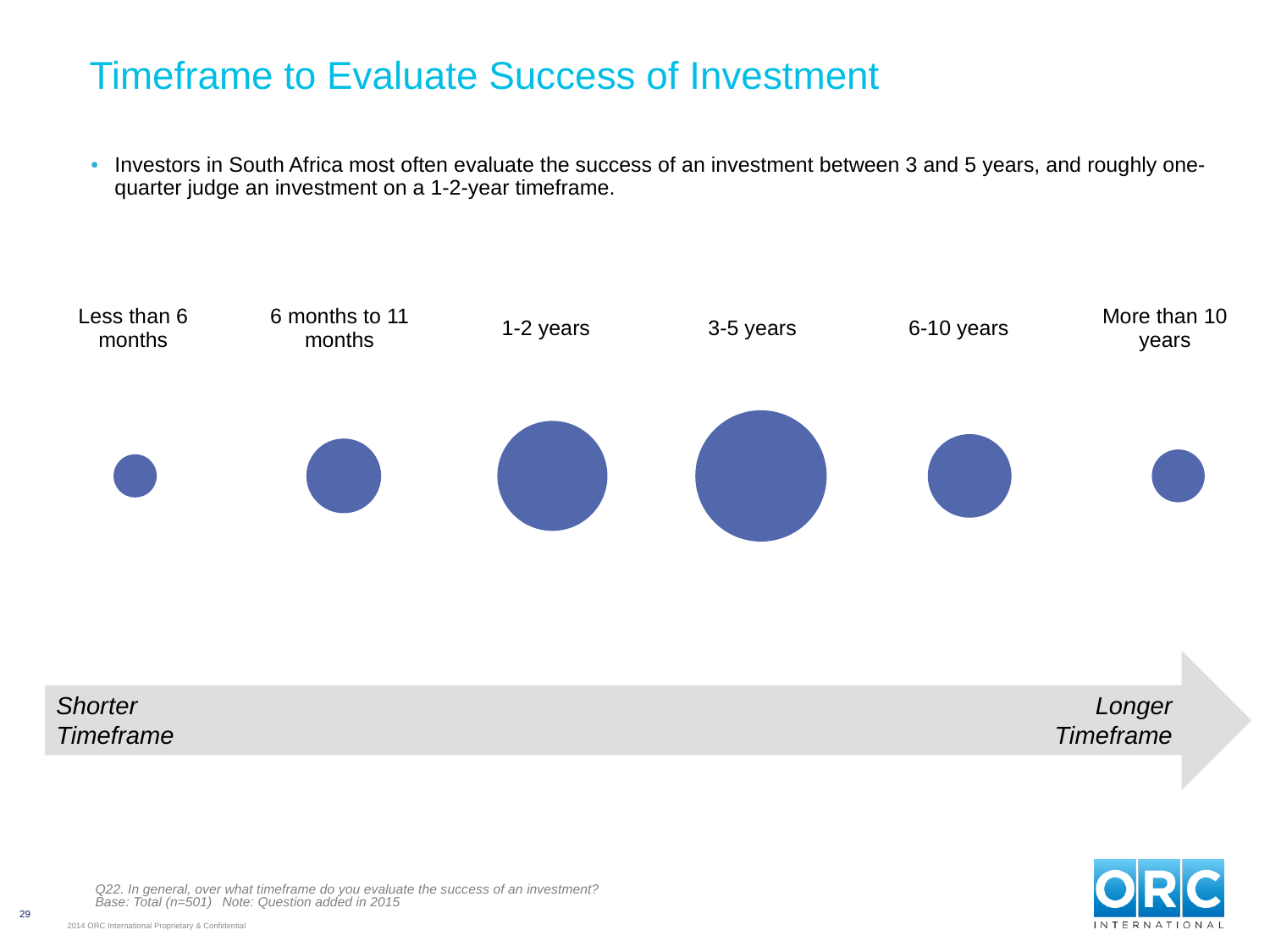
Which bubble is larger, 1-2 years or Less than 6 months? 1-2 years Which bubble is larger, 3-5 years or 6-10 years? 3-5 years Which category is the rightmost (longest timeframe) in the chart? More than 10 years What kind of chart is used to show the timeframe data? Bubble chart What colour are the bubbles in the chart? Blue What is the title of the chart on the slide? Timeframe to Evaluate Success of Investment Which bubble is larger, 3-5 years or 1-2 years? 3-5 years Which category is the leftmost (shortest timeframe) in the chart? Less than 6 months How many timeframe categories are shown in the chart? 6 Which timeframe category has the largest bubble? 3-5 years